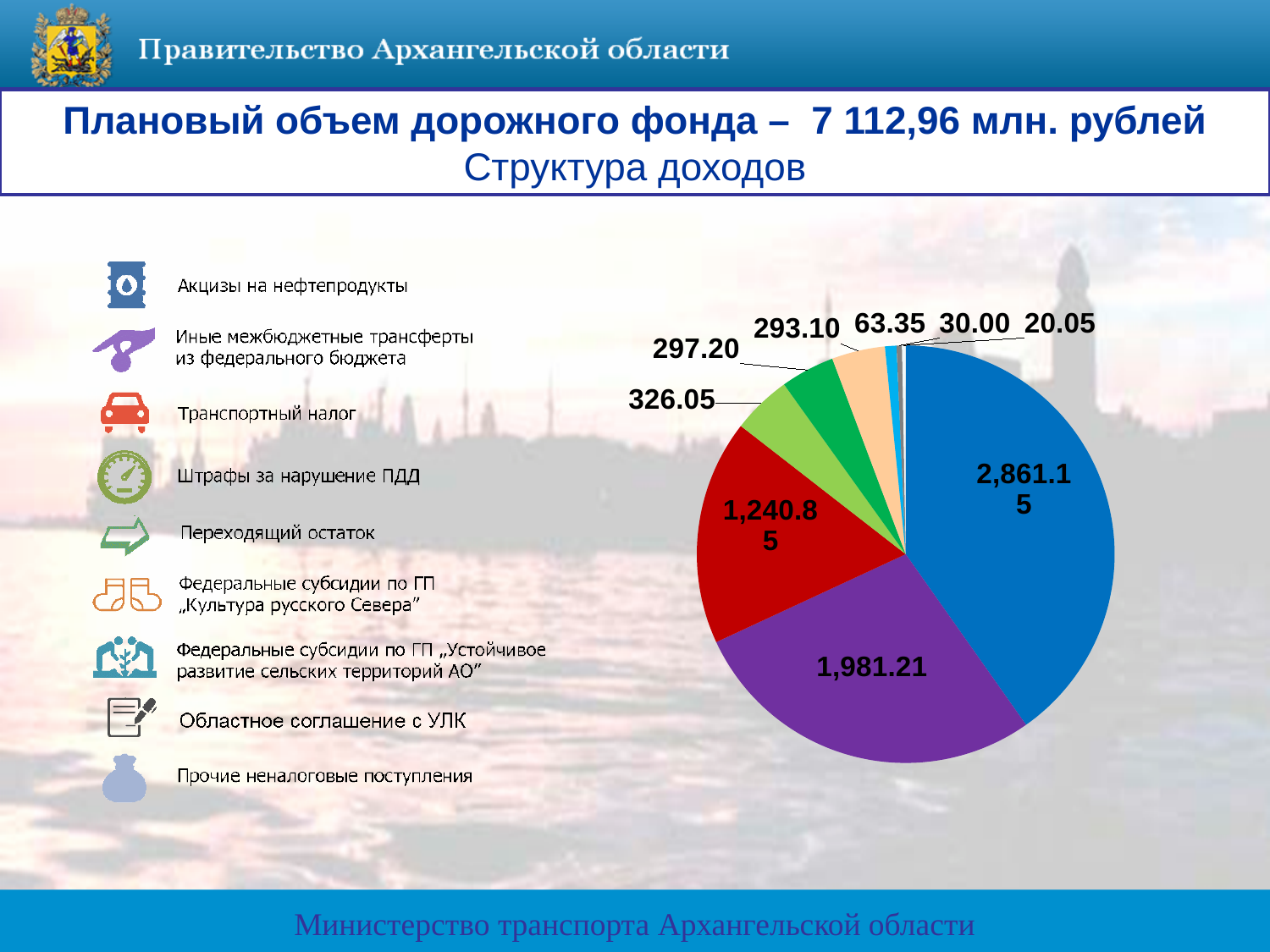
What is the value shown for the red slice of the pie chart? 1,240.85 What is the value of the smallest slice of the pie chart? 20.05 What is the value of the largest slice of the pie chart? 2,861.15 Which is larger: the slice labelled 326.05 or the slice labelled 297.20? 326.05 What is the value of the slice for Акцизы на нефтепродукты (blue)? 2,861.15 What kind of chart is shown on the slide? Pie chart Which legend entry is listed first on the left side of the slide? Акцизы на нефтепродукты What is the difference between the slices labelled 326.05 and 297.20? 28.85 What is the planned total volume of the road fund stated in the slide title? 7 112,96 млн. рублей What is the value shown for the purple slice of the pie chart? 1,981.21 How many slices does the pie chart have? 9 What is the difference between the largest slice (2,861.15) and the purple slice (1,981.21)? 879.94